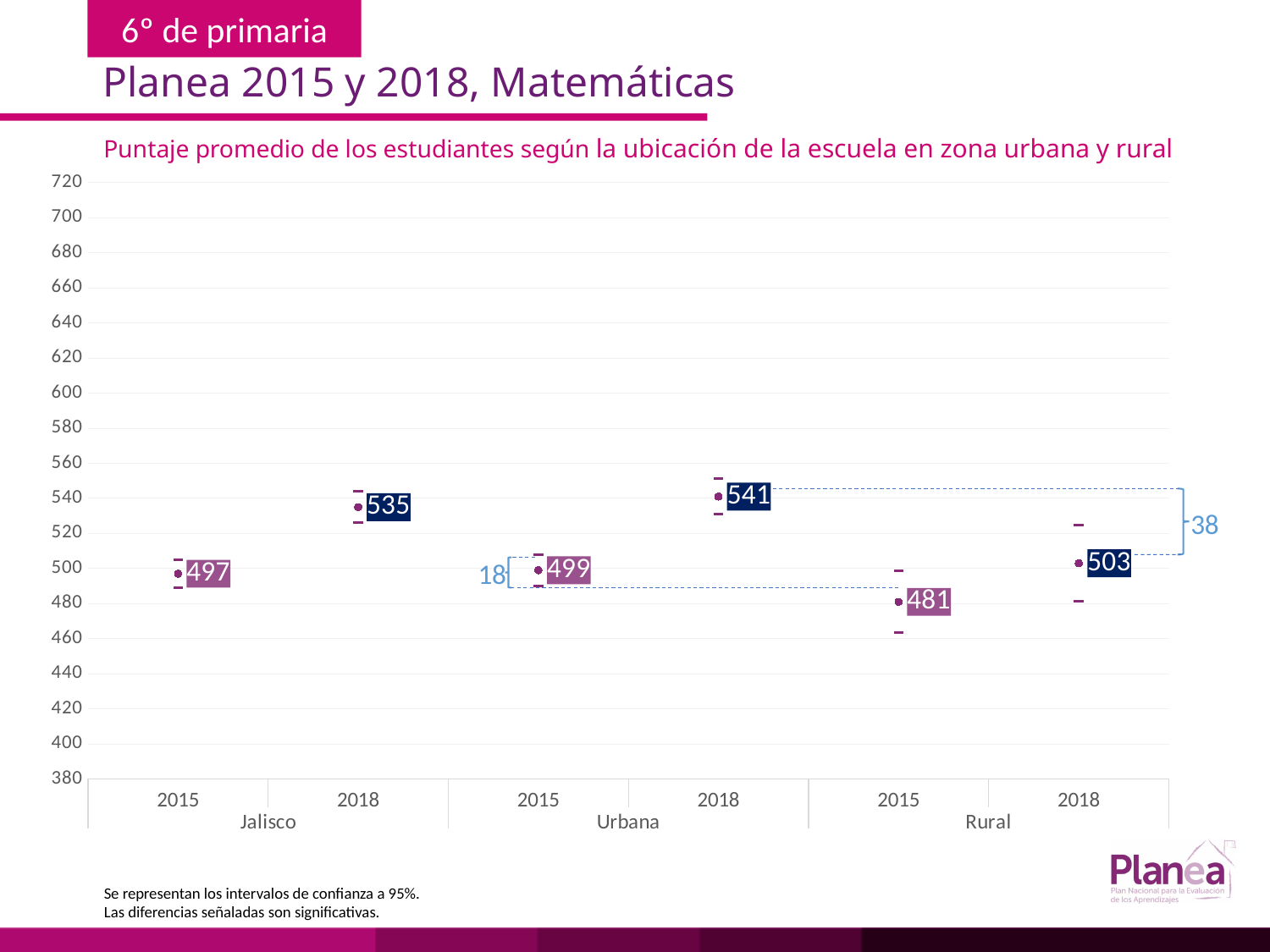
Which group and year has the lowest average score? Rural 2015 By how many points did the Jalisco average score increase from 2015 to 2018? 38 Which group and year has the highest average score? Urbana 2018 What is the average score for Urbana schools in 2018? 541 Did the average score for Rural schools rise or fall from 2015 to 2018? Rise What is the difference between the Urbana and Rural average scores in 2018? 38 What is the average score for Rural schools in 2015? 481 What is the average score for Rural schools in 2018? 503 Which had a higher average score in 2015, Urbana or Rural schools? Urbana What is the average score for Jalisco in 2015? 497 How many data points are plotted on the chart? 6 What is the difference between the Urbana and Rural average scores in 2015? 18